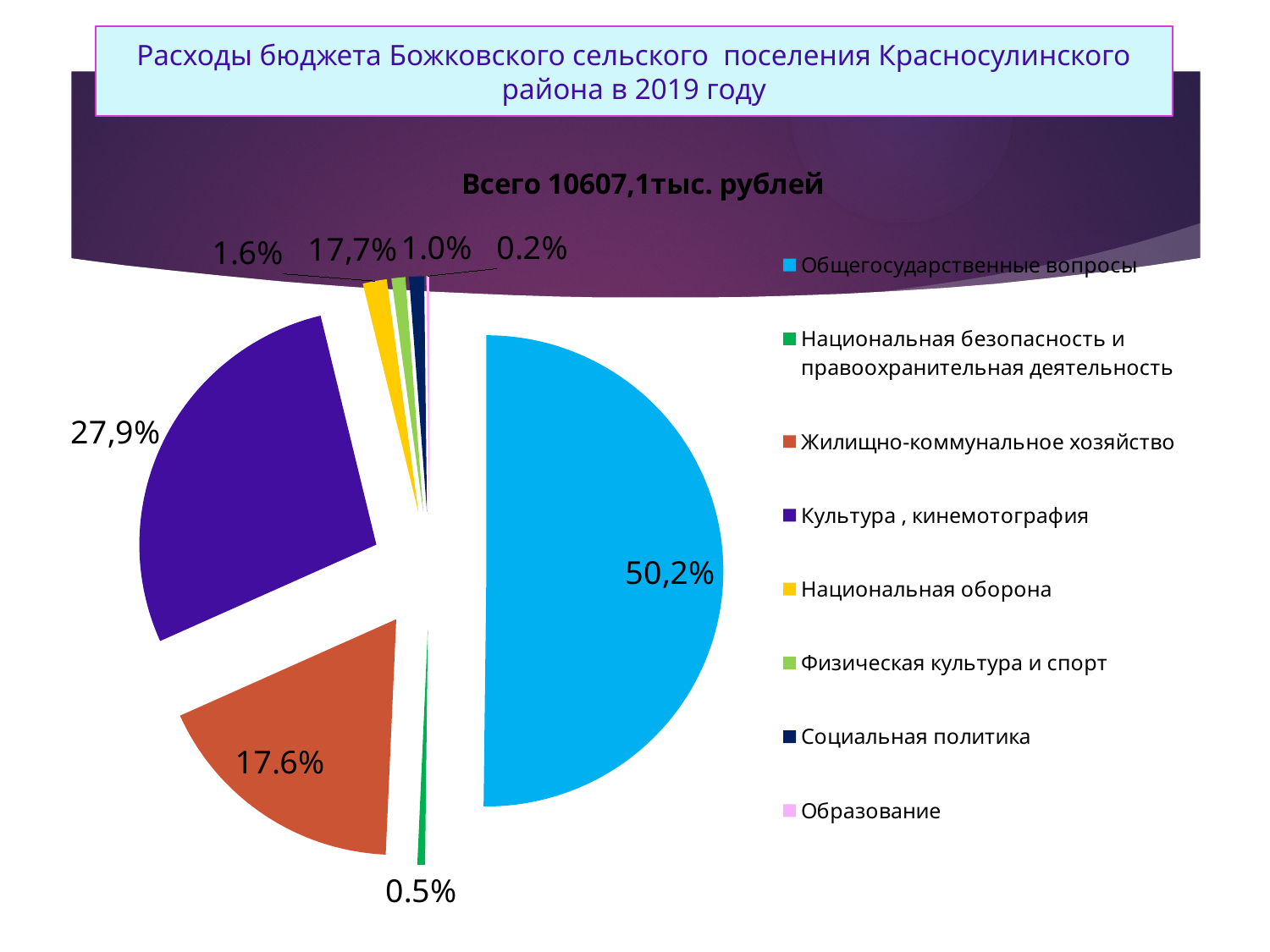
What share of the budget expenditure goes to Социальная политика? 1.0% Which category has the smallest share of the budget expenditure? Образование What share of the budget expenditure goes to Национальная безопасность и правоохранительная деятельность? 0.5% What share of the budget expenditure goes to Образование? 0.2% What share of the budget expenditure goes to Общегосударственные вопросы? 50,2% What share of the budget expenditure goes to Национальная оборона? 1.6% What kind of chart is shown on the slide? pie chart What share of the budget expenditure goes to Жилищно-коммунальное хозяйство? 17.6% Which category has the largest share of the budget expenditure? Общегосударственные вопросы Which has the larger share: Жилищно-коммунальное хозяйство or Культура, кинемотография? Культура, кинемотография What share of the budget expenditure goes to Культура, кинемотография? 27,9% How many categories does the legend list? 8